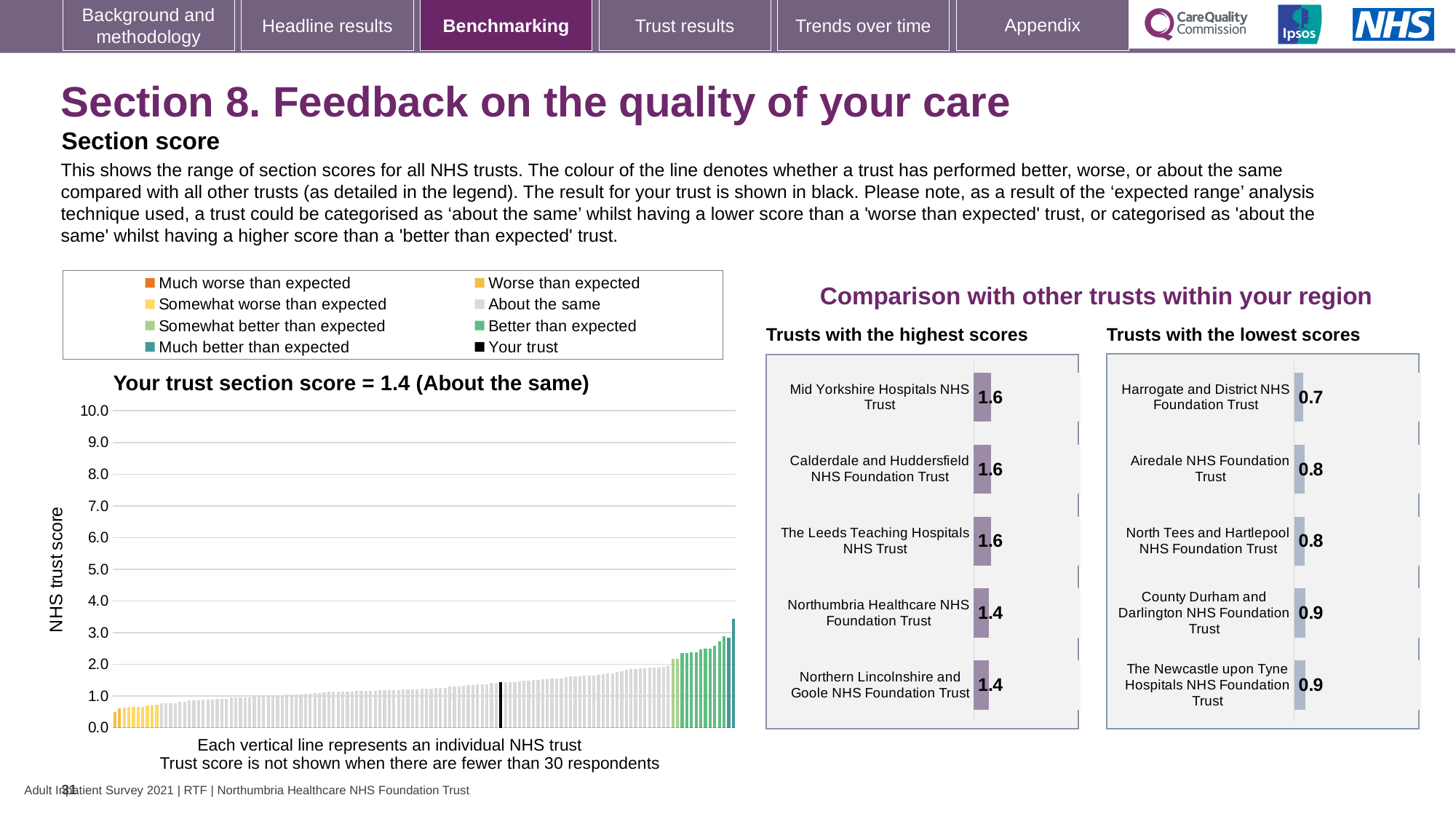
In the chart 'Trusts with the highest scores', what is the score for Mid Yorkshire Hospitals NHS Trust? 1.6 In the chart titled 'Your trust section score', what is the section score for your trust? 1.4 In the chart 'Trusts with the lowest scores', which trust has the lowest score? Harrogate and District NHS Foundation Trust In the chart 'Trusts with the highest scores', how many trusts are listed? 5 In the chart titled 'Your trust section score', is the value of the tallest bar greater or less than 3.0? greater In the chart titled 'Your trust section score', what kind of chart is used to show the NHS trust scores? bar chart In the chart 'Trusts with the lowest scores', which has the larger score: Harrogate and District NHS Foundation Trust or The Newcastle upon Tyne Hospitals NHS Foundation Trust? The Newcastle upon Tyne Hospitals NHS Foundation Trust In the chart 'Trusts with the highest scores', what is the score for Northern Lincolnshire and Goole NHS Foundation Trust? 1.4 In the chart 'Trusts with the lowest scores', what is the score for Airedale NHS Foundation Trust? 0.8 In the chart titled 'Your trust section score', what is the highest value shown on the vertical axis? 10.0 In the chart 'Trusts with the highest scores', what is the difference between the scores of Mid Yorkshire Hospitals NHS Trust and Northumbria Healthcare NHS Foundation Trust? 0.2 In the chart titled 'Your trust section score', do the trust scores rise or fall from left to right? rise